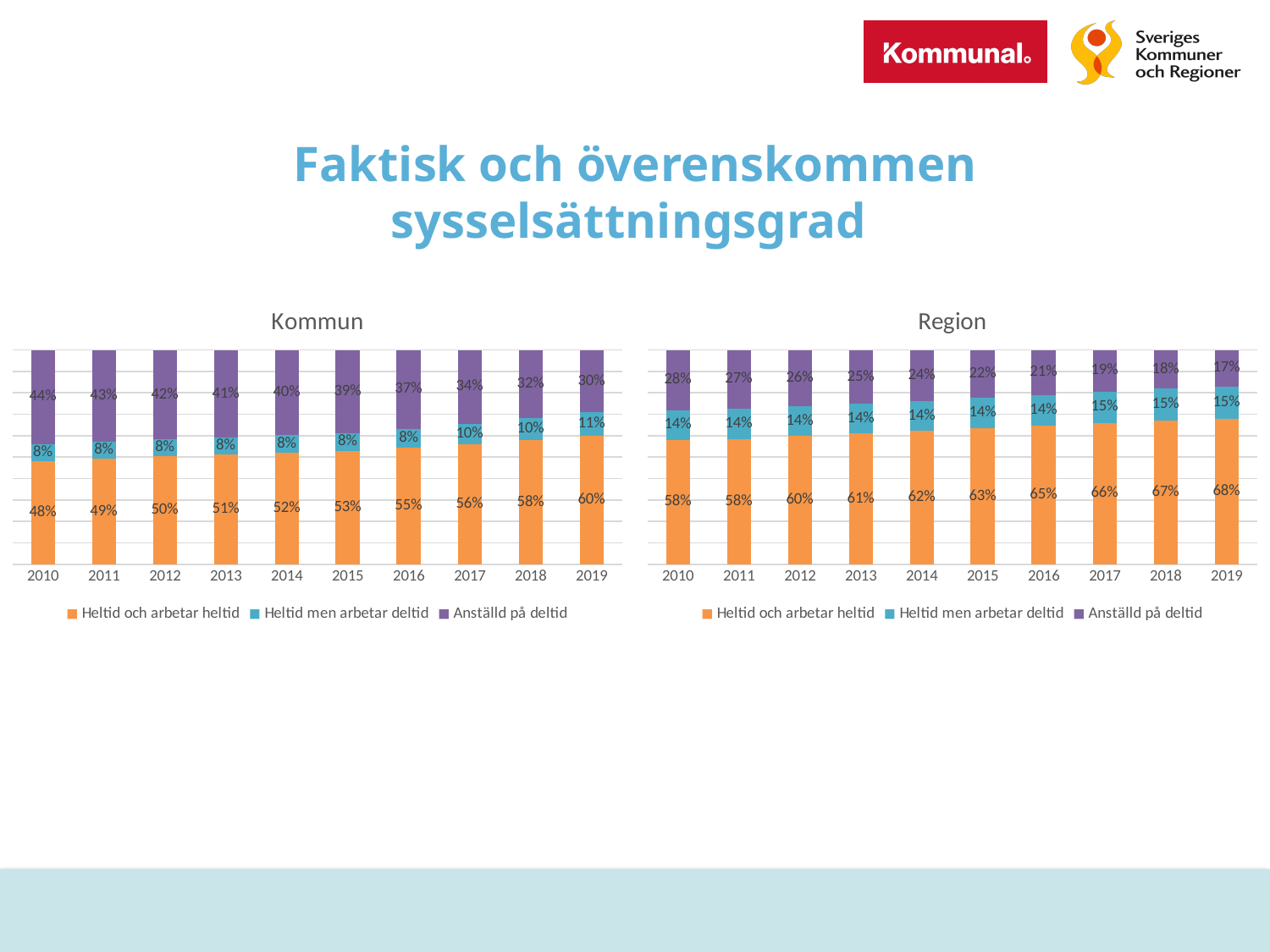
In the Region chart, what is the total of the stacked bar for 2019? 100% In the Kommun chart, which year has the lowest value for Anställd på deltid? 2019 How many years are shown on the x axis of the Kommun chart? 10 How many series does the legend of the Region chart list? 3 In the Kommun chart, what is the difference between the Heltid och arbetar heltid values for 2019 and 2010? 12% In the Region chart, does the value for Anställd på deltid rise or fall from 2010 to 2019? Fall In the Kommun chart, what is the value for Heltid och arbetar heltid in 2019? 60% In the Region chart, what is the value for Anställd på deltid in 2010? 28% In the Region chart, which year has the highest value for Heltid och arbetar heltid? 2019 In the Region chart, which is larger in 2015: Heltid och arbetar heltid or Anställd på deltid? Heltid och arbetar heltid What kind of chart is the Kommun chart? Stacked bar chart In the Kommun chart, what is the value for Heltid men arbetar deltid in 2017? 10%